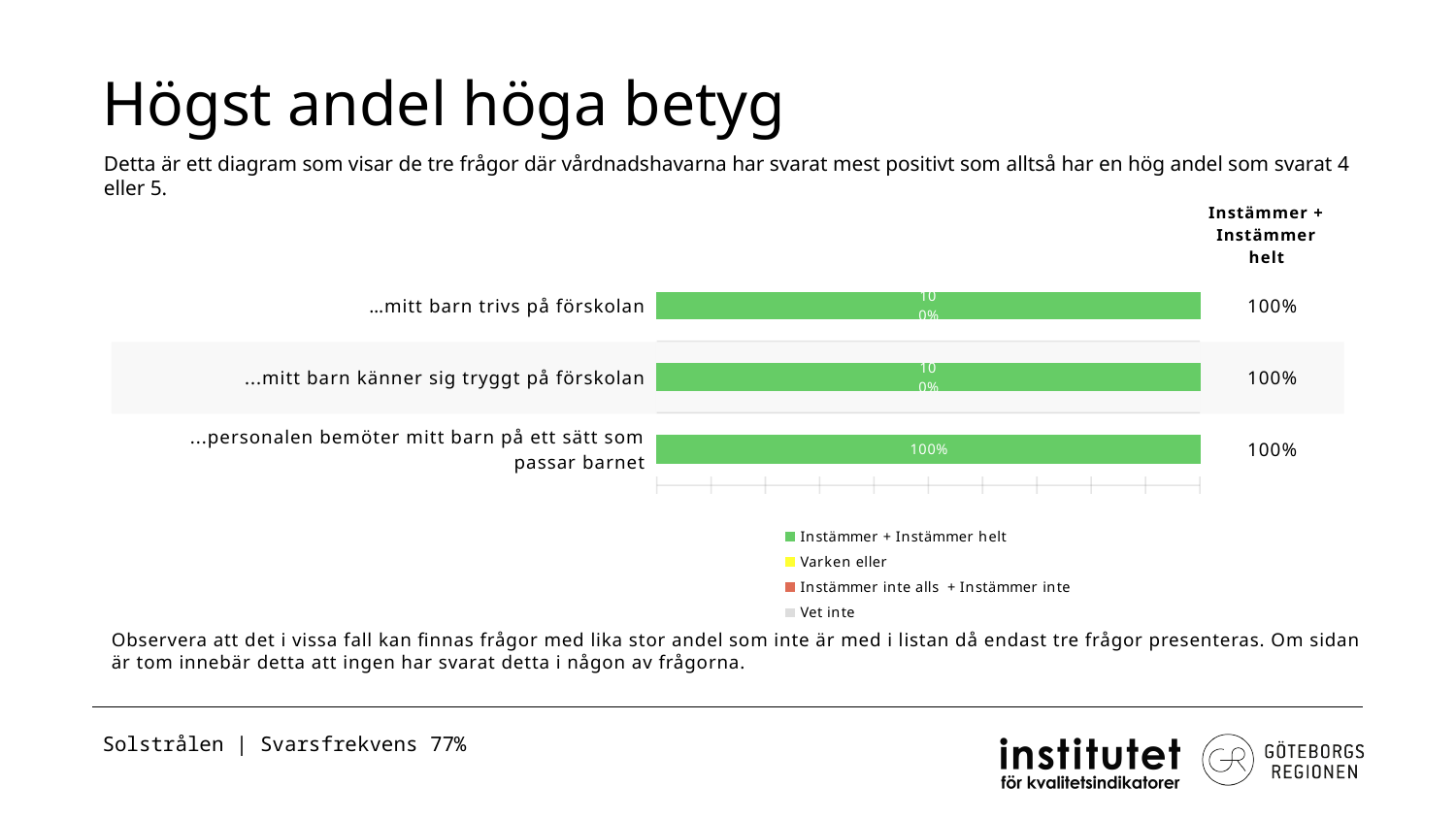
Which legend entry is shown in green? Instämmer + Instämmer helt What is the title of the slide containing the chart? Högst andel höga betyg What is the difference between the "Instämmer + Instämmer helt" values for "…mitt barn trivs på förskolan" and "...mitt barn känner sig tryggt på förskolan"? 0% What kind of chart is shown on the slide? Bar chart How many questions (categories) are shown in the chart? 3 What is the "Instämmer + Instämmer helt" value for "…mitt barn trivs på förskolan"? 100% What is the "Instämmer + Instämmer helt" value for "...mitt barn känner sig tryggt på förskolan"? 100% Is the "Instämmer + Instämmer helt" value for "…mitt barn trivs på förskolan" larger than, smaller than, or equal to the value for "...personalen bemöter mitt barn på ett sätt som passar barnet"? Equal What is the response rate (Svarsfrekvens) shown at the bottom of the slide? 77% How many series does the legend list? 4 What is the "Instämmer + Instämmer helt" value for "...personalen bemöter mitt barn på ett sätt som passar barnet"? 100%